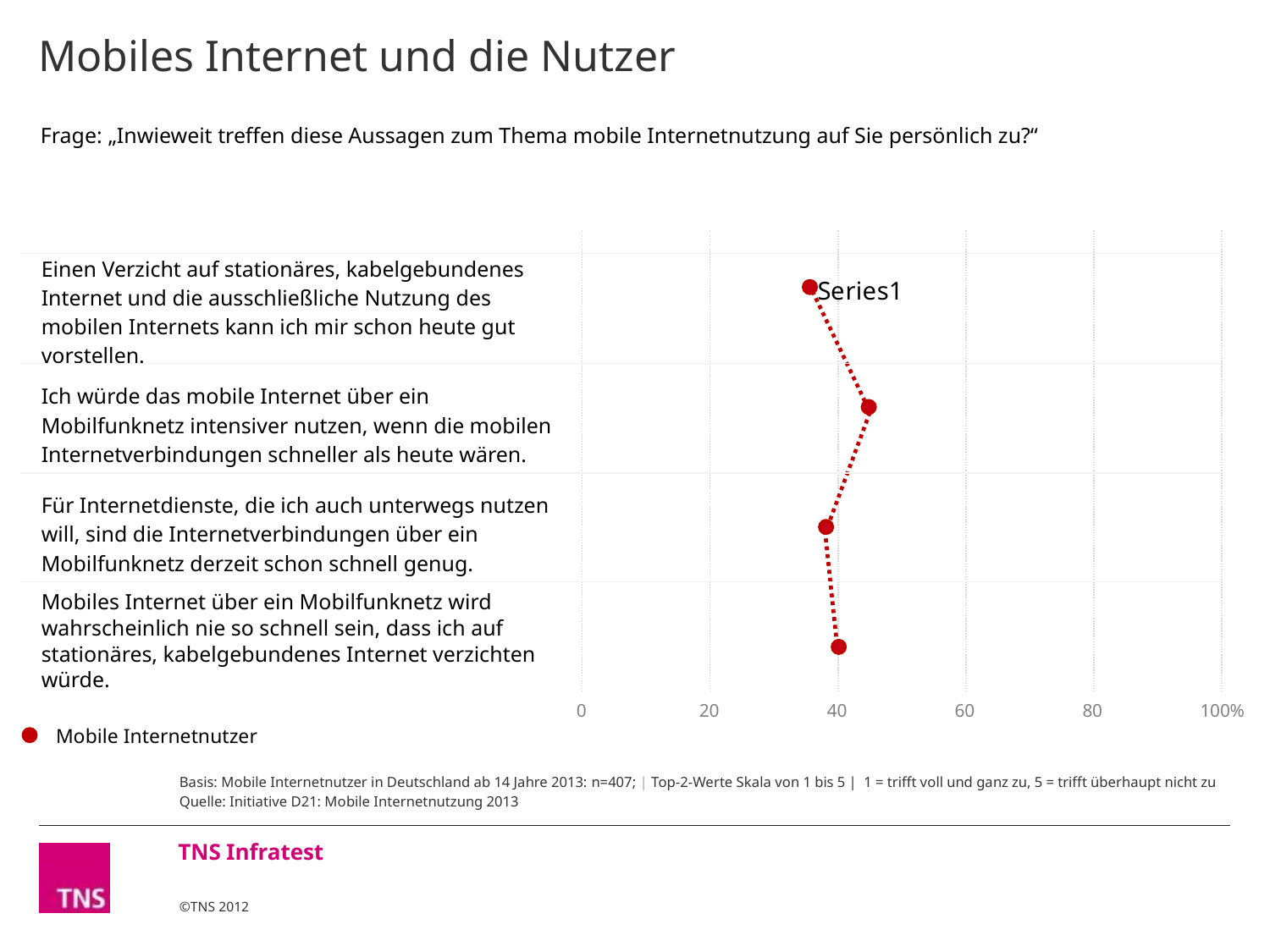
How many statements (categories) are plotted in the chart? 4 What is the highest value shown on the horizontal axis? 100% Which has the larger value: the statement about using mobile internet more intensively if connections were faster, or the statement that mobile internet will probably never be fast enough to give up wired internet? the statement about using mobile internet more intensively if connections were faster Is the value for "Einen Verzicht auf stationäres, kabelgebundenes Internet ... kann ich mir schon heute gut vorstellen" greater or less than 40? less What is the name of the series shown in the legend? Mobile Internetnutzer Is the value for "Ich würde das mobile Internet über ein Mobilfunknetz intensiver nutzen ..." greater or less than 60? less Is the value for "Für Internetdienste, die ich auch unterwegs nutzen will, sind die Internetverbindungen über ein Mobilfunknetz derzeit schon schnell genug" greater or less than 40? less How many series does the legend list? 1 Which statement has the highest value? Ich würde das mobile Internet über ein Mobilfunknetz intensiver nutzen, wenn die mobilen Internetverbindungen schneller als heute wären. What kind of chart is shown on the slide? line chart